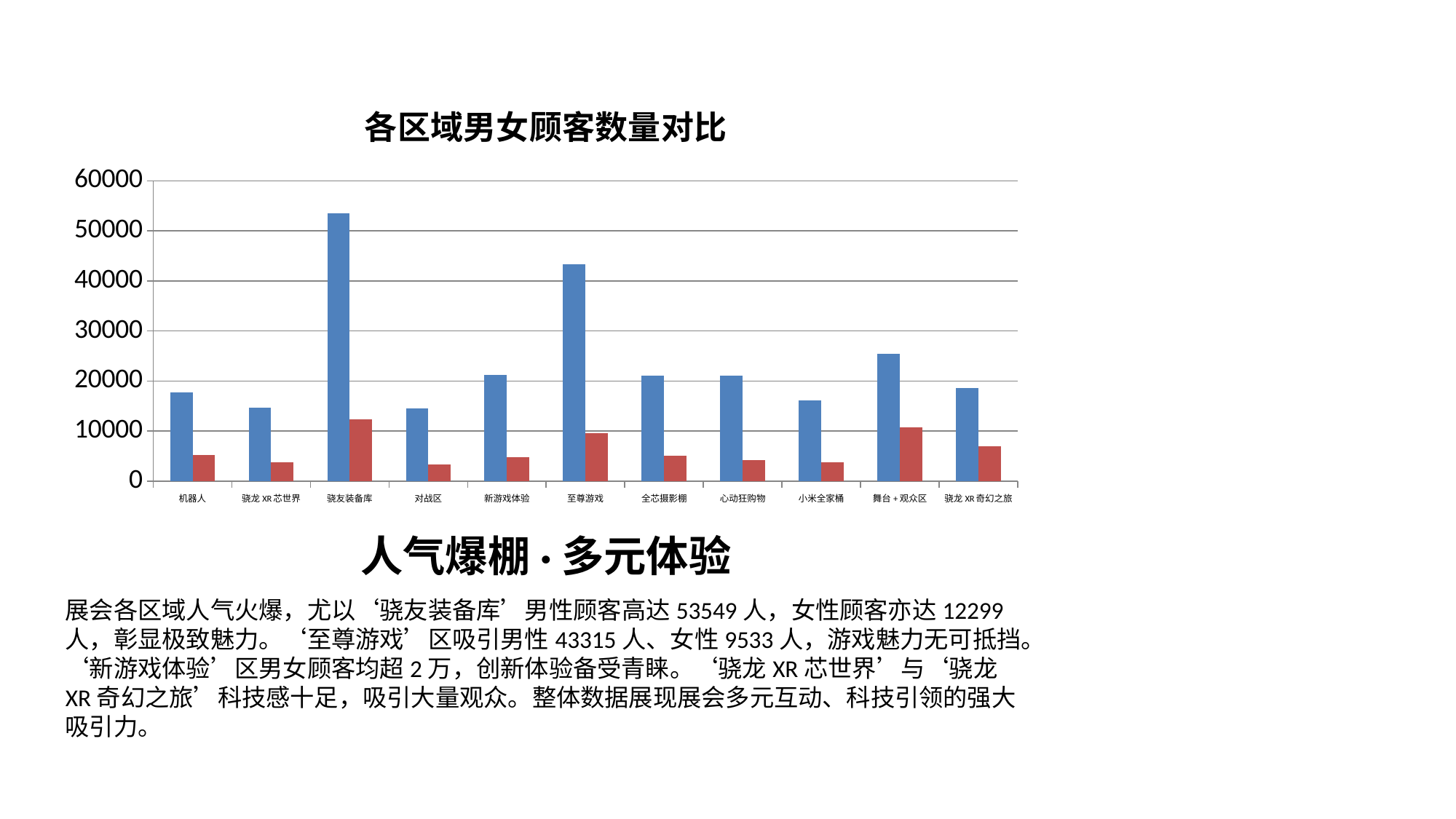
Is the blue bar for 至尊游戏 greater or less than 40000? greater Which region has the larger blue bar, 骁友装备库 or 至尊游戏? 骁友装备库 Is the blue bar for 机器人 greater or less than 20000? less Which region has the larger red bar, 骁龙XR奇幻之旅 or 机器人? 骁龙XR奇幻之旅 What is the title of the chart? 各区域男女顾客数量对比 What type of chart is shown on the slide? Bar chart Which region has the tallest blue bar in the chart? 骁友装备库 How many categories (regions) are shown on the x axis of the chart? 11 Which region has the tallest red bar in the chart? 骁友装备库 Is the blue bar for 骁友装备库 greater or less than 50000? greater